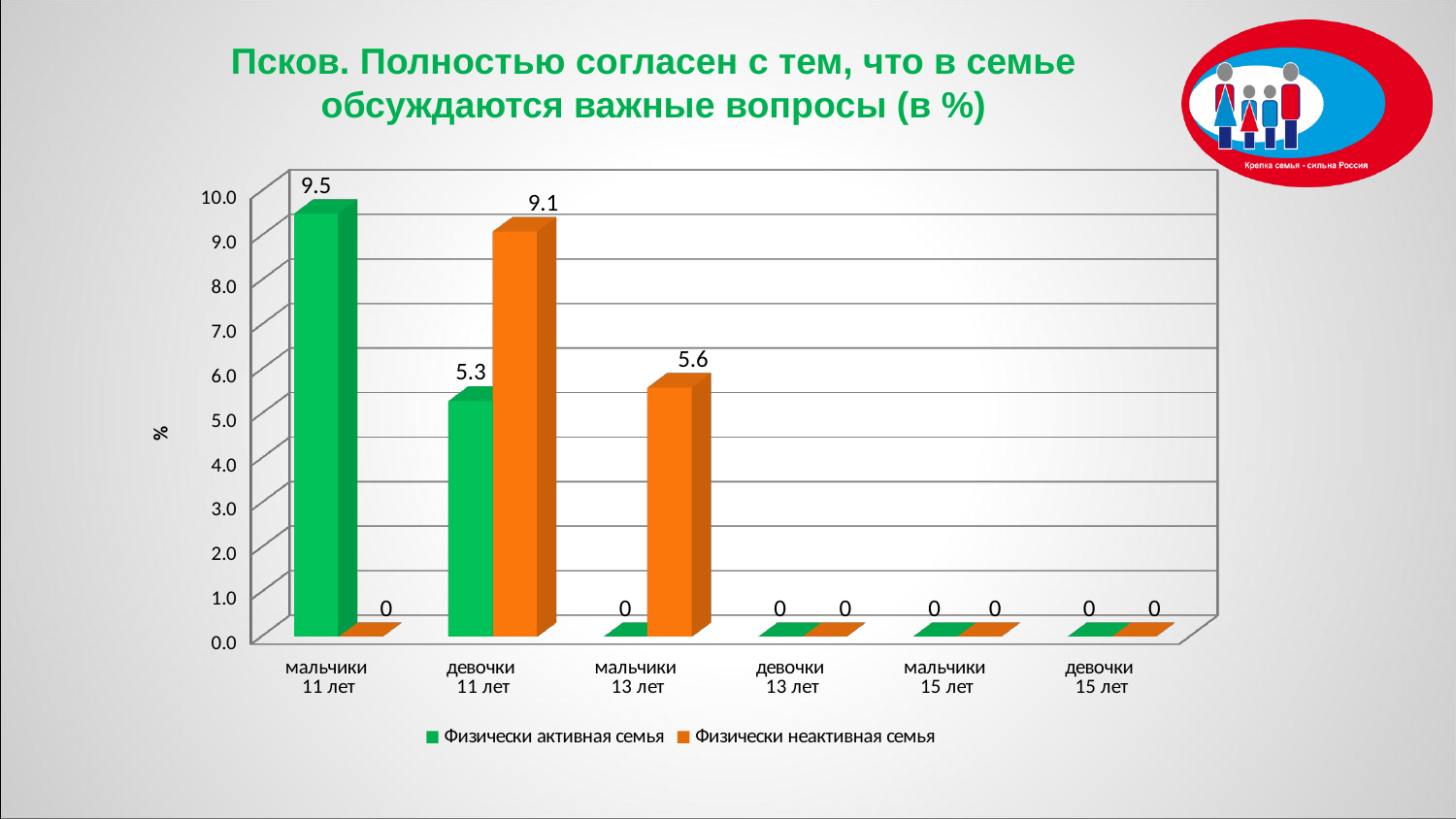
Which category has the highest value for 'Физически неактивная семья'? девочки 11 лет What is the value for 'Физически неактивная семья' for 'девочки 11 лет'? 9.1 What is the value for 'Физически активная семья' for 'девочки 11 лет'? 5.3 What kind of chart is shown on the slide? bar chart How many series does the legend list? 2 What is the difference between the 'Физически неактивная семья' and 'Физически активная семья' values for 'девочки 11 лет'? 3.8 What is the value for 'Физически активная семья' for 'мальчики 11 лет'? 9.5 What colour represents 'Физически неактивная семья' in the chart? orange Which category has the highest value for 'Физически активная семья'? мальчики 11 лет Which is larger for 'мальчики 11 лет': 'Физически активная семья' or 'Физически неактивная семья'? Физически активная семья How many categories are shown on the x axis? 6 What is the value for 'Физически неактивная семья' for 'мальчики 13 лет'? 5.6